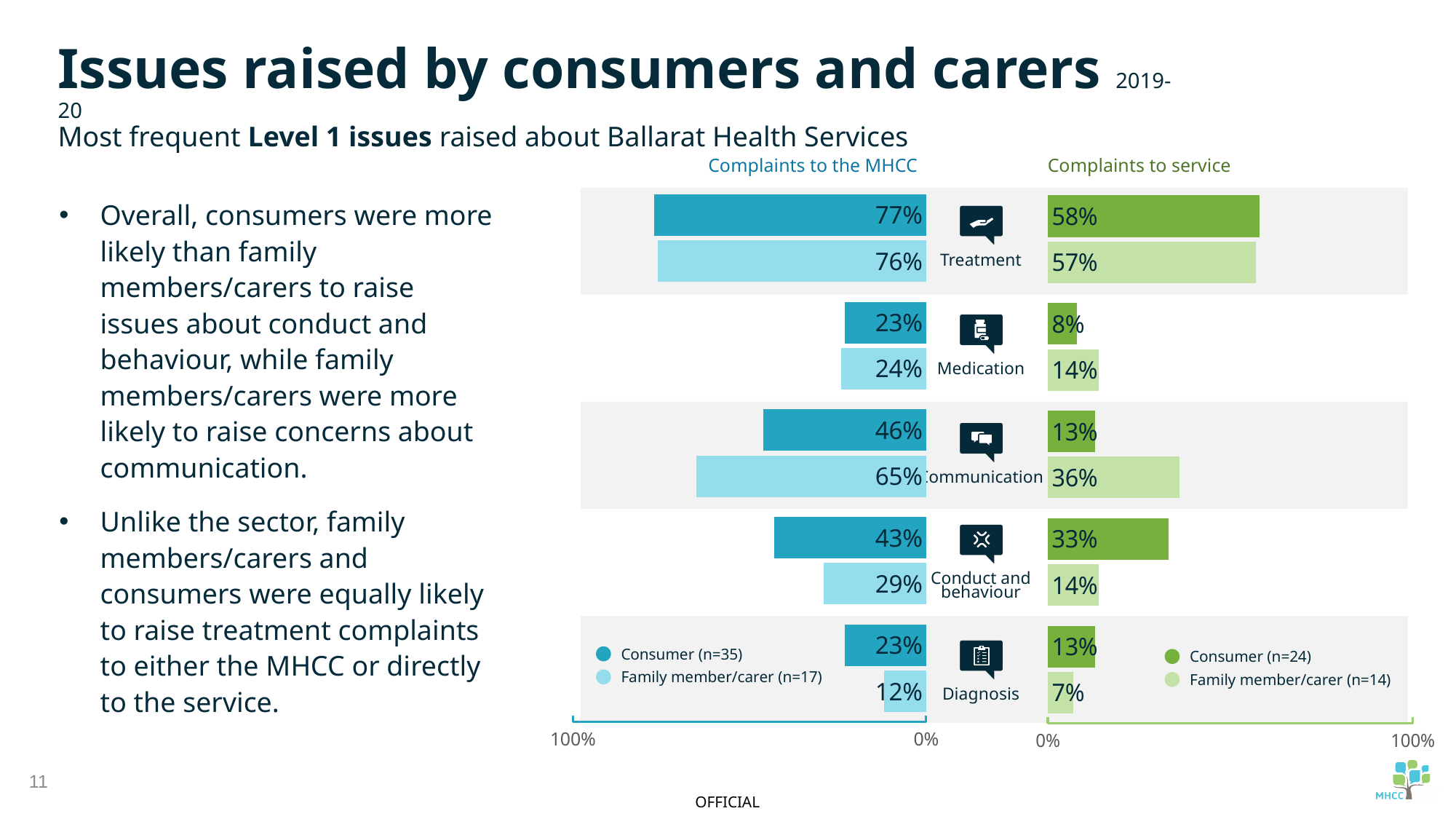
In the 'Complaints to the MHCC' chart, what percentage of consumers raised Treatment issues? 77% How many series does the legend of the 'Complaints to service' chart list? 2 How many issue categories are shown in the 'Complaints to the MHCC' chart? 5 In the 'Complaints to service' chart, what is the difference between the Consumer and Family member/carer values for Medication? 6% What type of chart is the 'Complaints to the MHCC' chart? Bar chart In the 'Complaints to service' chart, what percentage of family members/carers raised Communication issues? 36% According to the legend of the 'Complaints to service' chart, what is the sample size (n) for Consumer? n=24 In the 'Complaints to the MHCC' chart, what is the difference between the Family member/carer and Consumer values for Communication? 19% In the 'Complaints to service' chart, which issue has the lowest Family member/carer value? Diagnosis In the 'Complaints to the MHCC' chart, what is the Family member/carer value for Diagnosis? 12% In the 'Complaints to service' chart, which issue has the highest Consumer value? Treatment In the 'Complaints to the MHCC' chart, which is larger for Conduct and behaviour: the Consumer value or the Family member/carer value? Consumer